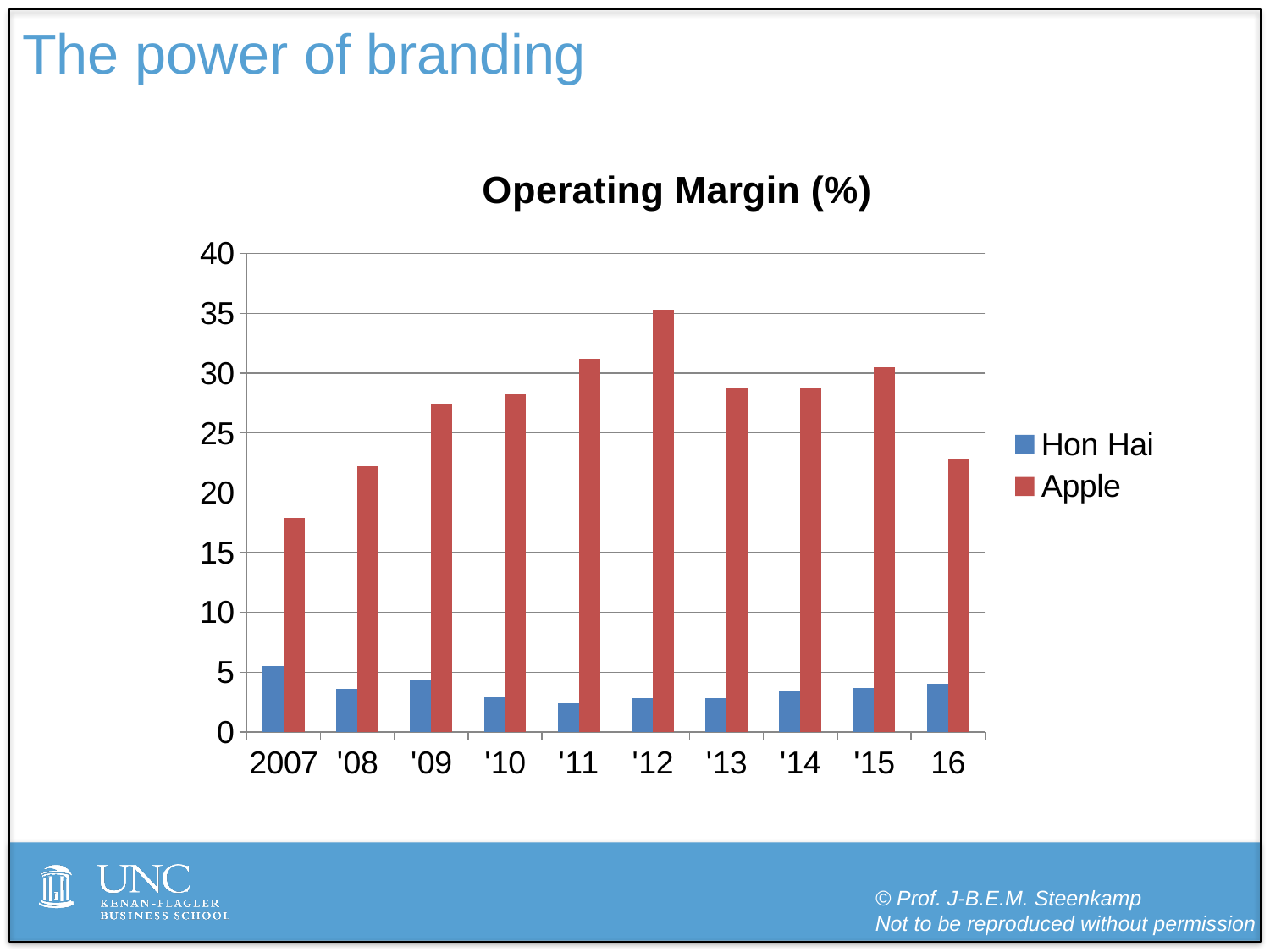
In which year is Hon Hai's operating margin highest? 2007 In which year is Apple's operating margin highest? '12 Which is larger, Apple's operating margin in '12 or in '15? '12 How many series does the legend list? 2 Is Apple's operating margin in '12 greater or less than 30? greater What is the title of the chart? Operating Margin (%) How many years are shown on the x axis? 10 Is Apple's operating margin in 2007 greater or less than 20? less In which year is Apple's operating margin lowest? 2007 What kind of chart is shown on the slide? Bar chart Is Hon Hai's operating margin in '11 greater or less than 5? less Does Apple's operating margin rise or fall from 2007 to '12? rise